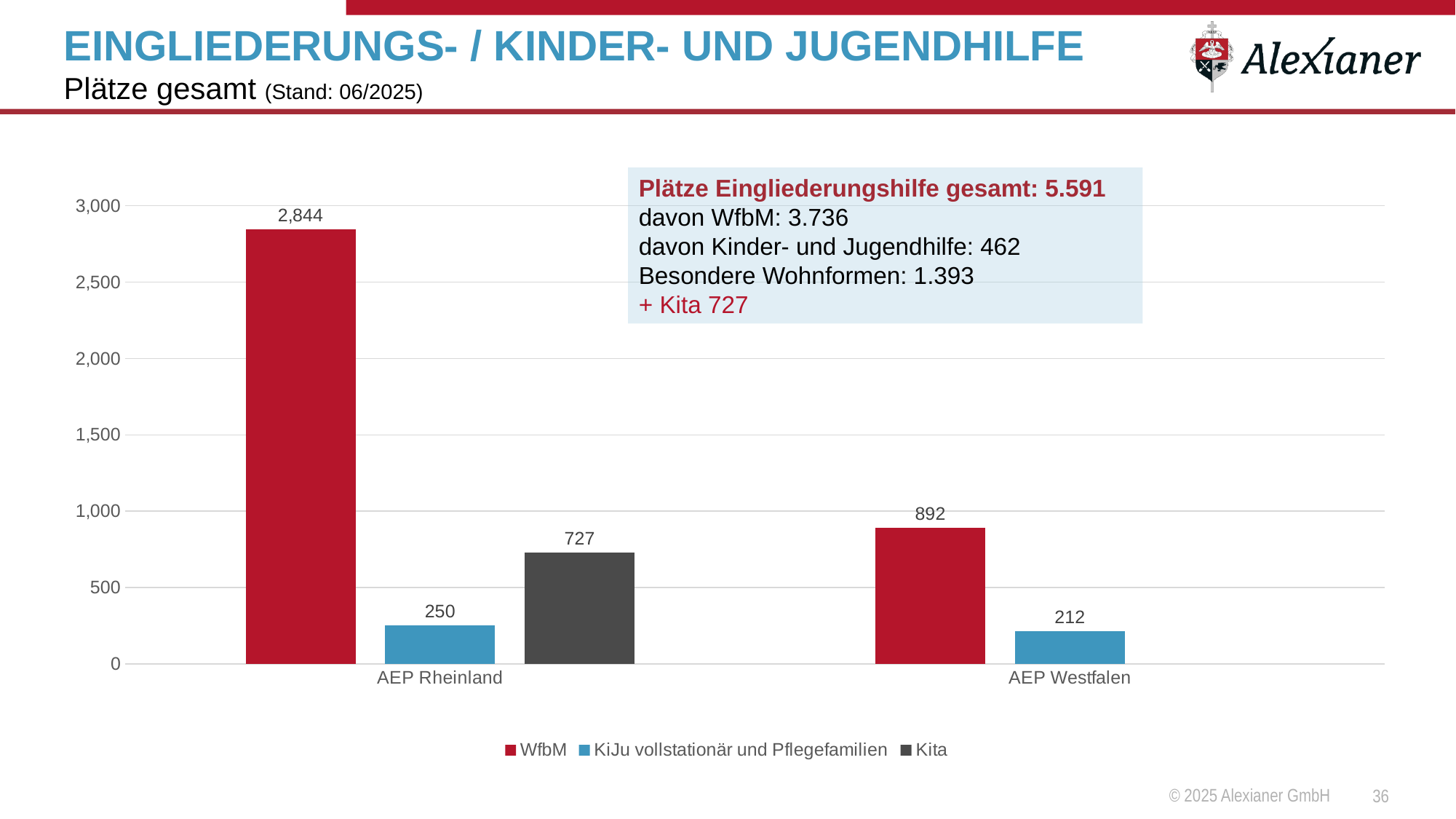
Which category has the highest WfbM value? AEP Rheinland What kind of chart is shown on the slide? bar chart What is the WfbM value for AEP Westfalen? 892 What is the WfbM value for AEP Rheinland? 2,844 What is the value for KiJu vollstationär und Pflegefamilien at AEP Westfalen? 212 Is the WfbM value for AEP Westfalen greater or less than 1,000? less Which is larger: the KiJu vollstationär und Pflegefamilien value for AEP Rheinland or for AEP Westfalen? AEP Rheinland What is the difference between the WfbM values for AEP Rheinland and AEP Westfalen? 1,952 What is the Kita value for AEP Rheinland? 727 How many series does the legend list? 3 How many categories are shown on the x axis? 2 Which series has the lowest value at AEP Westfalen? KiJu vollstationär und Pflegefamilien